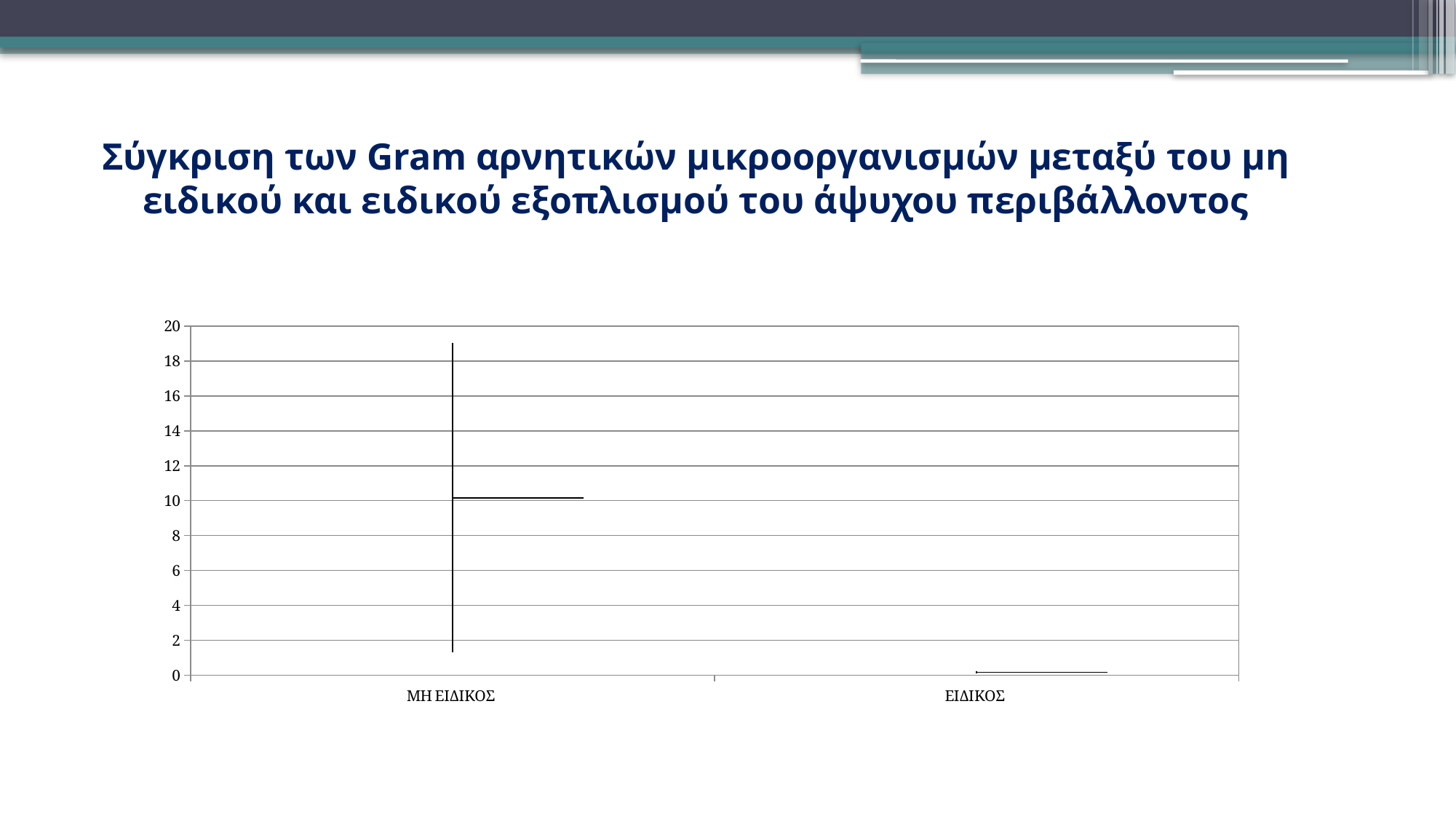
Is the value for ΕΙΔΙΚΟΣ greater or less than 2? less How many categories are shown on the x axis? 2 Which category has the higher value, ΜΗ ΕΙΔΙΚΟΣ or ΕΙΔΙΚΟΣ? ΜΗ ΕΙΔΙΚΟΣ What is the label of the first category on the x axis? ΜΗ ΕΙΔΙΚΟΣ Which category has the highest value? ΜΗ ΕΙΔΙΚΟΣ Do the values rise or fall from ΜΗ ΕΙΔΙΚΟΣ to ΕΙΔΙΚΟΣ? fall What is the maximum value shown on the y axis? 20 Is the value for ΕΙΔΙΚΟΣ greater or less than 4? less Which category has the lowest value? ΕΙΔΙΚΟΣ